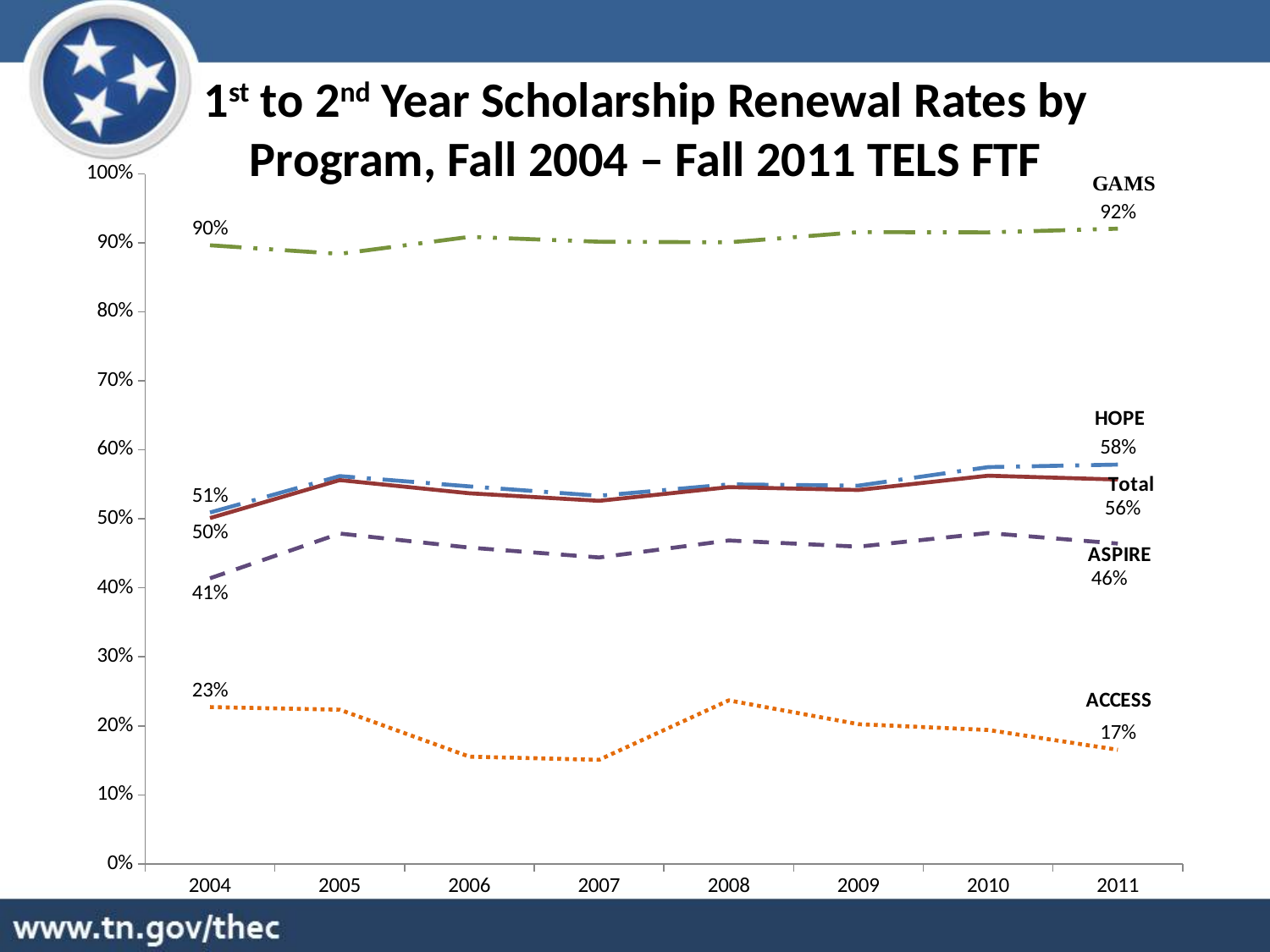
Which program has the highest renewal rate in 2011? GAMS Which program has the lowest renewal rate in 2004? ACCESS Is the ACCESS renewal rate in 2007 greater or less than 20%? less Did the ACCESS renewal rate rise or fall from 2004 to 2011? Fall By how many percentage points did the GAMS renewal rate change from 2004 to 2011? 2 percentage points What is the ACCESS renewal rate in 2004? 23% What is the ASPIRE renewal rate in 2011? 46% How many years are plotted along the x axis? 8 What kind of chart is shown on the slide? Line chart What is the GAMS renewal rate in 2011? 92% How many program lines are plotted on the chart? 5 What is the difference between the HOPE and ACCESS renewal rates in 2011? 41 percentage points